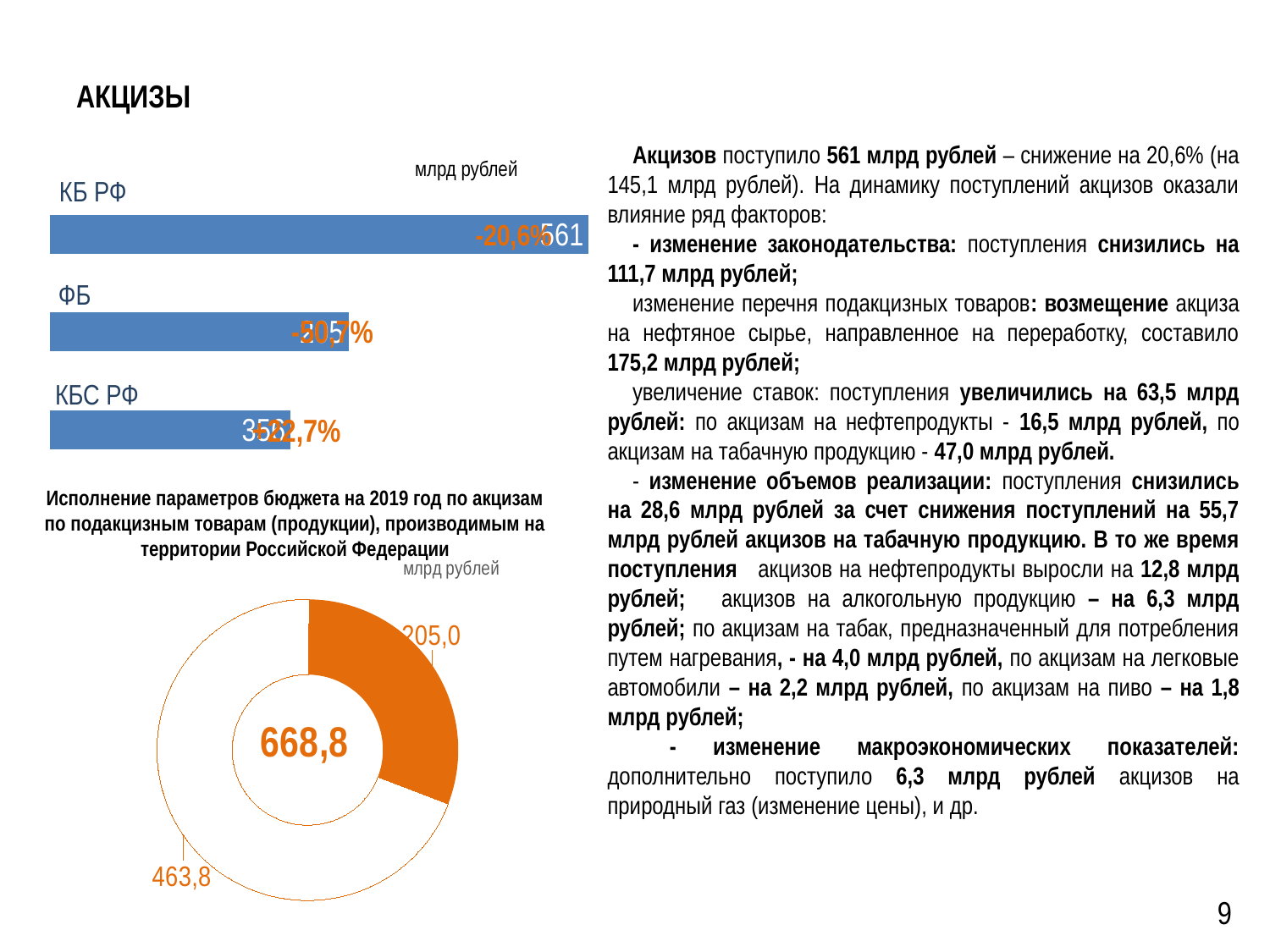
In the bar chart at the top left, what value is shown for КБ РФ? 561 In the doughnut chart at the bottom left, what value is shown for the orange segment? 205,0 In the bar chart at the top left, what percentage change is shown for КБ РФ? -20,6% In the bar chart at the top left, which category has the longest bar? КБ РФ In the doughnut chart at the bottom left, what total is shown in the centre? 668,8 In the doughnut chart at the bottom left, what is the difference between the two segment values, 463,8 and 205,0? 258,8 In the doughnut chart at the bottom left, what value is shown for the larger (white) segment? 463,8 What kind of chart is the chart at the bottom left of the slide? doughnut chart In the bar chart at the top left, which category has the shortest bar? КБС РФ How many categories does the bar chart at the top left show? 3 What kind of chart is the chart at the top left of the slide? bar chart In the bar chart at the top left, which bar is longer: ФБ or КБС РФ? ФБ